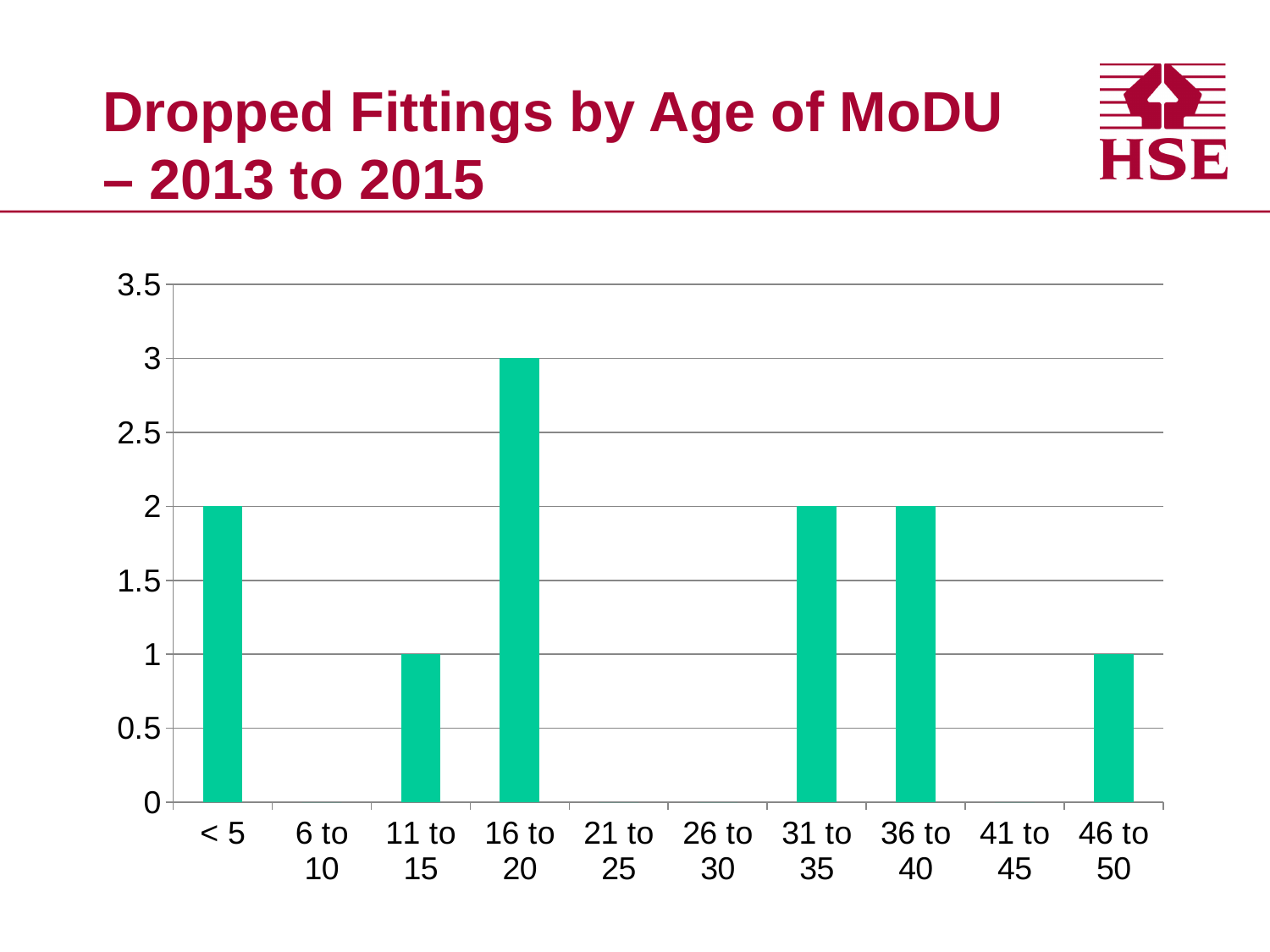
What is the value for the 11 to 15 age category? 1 What is the value for the 16 to 20 age category? 3 What is the title of the chart on the slide? Dropped Fittings by Age of MoDU – 2013 to 2015 What is the difference between the values for 16 to 20 and 11 to 15? 2 What is the value for the 36 to 40 age category? 2 Which age category has the highest value? 16 to 20 Is the value for 16 to 20 greater or less than 2.5? greater How many age categories are shown on the x axis? 10 What type of chart is shown on the slide? bar chart What is the value for the 46 to 50 age category? 1 What is the value for the < 5 age category? 2 Which is larger, the value for < 5 or the value for 46 to 50? < 5